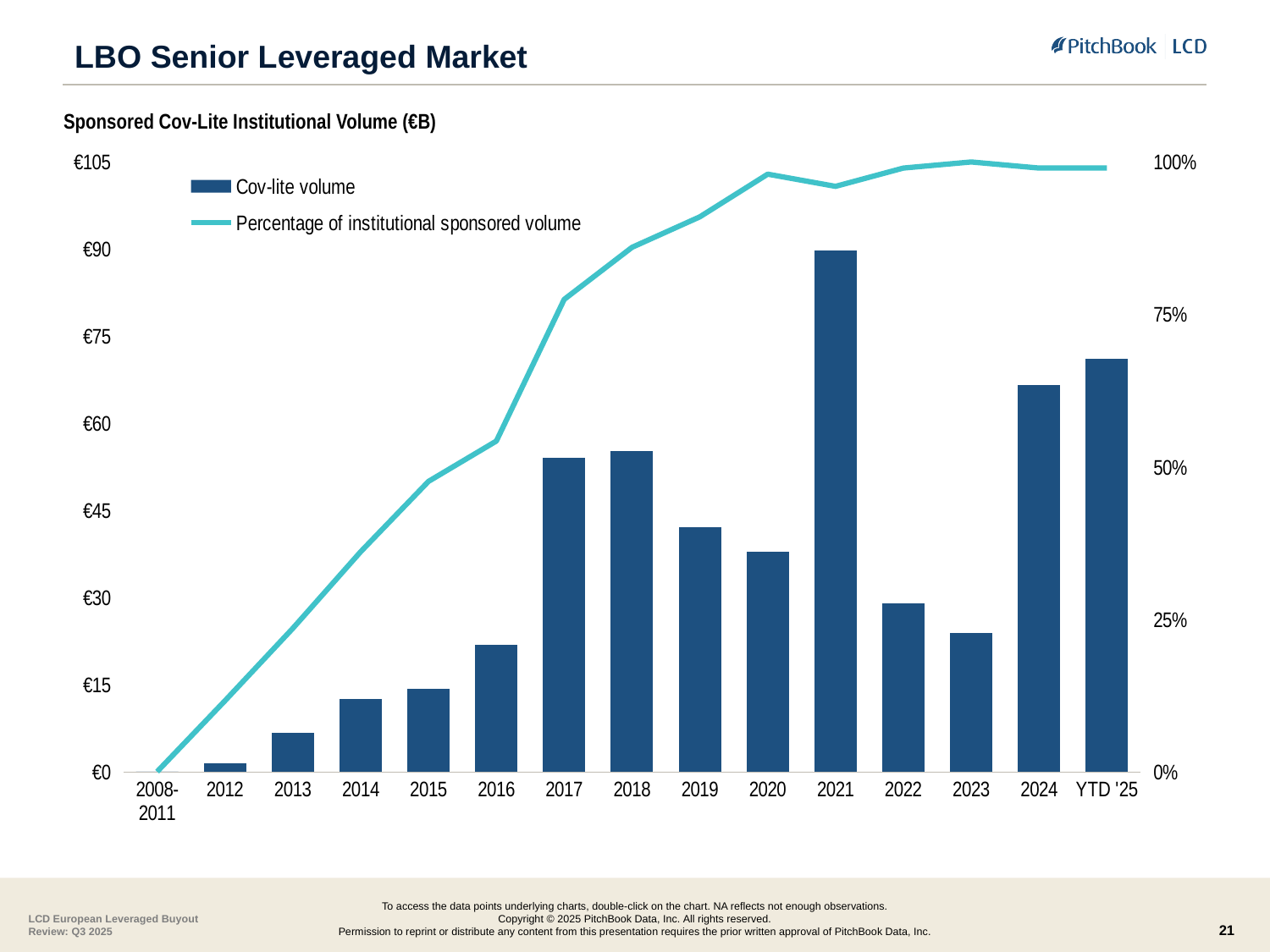
What is the title of the chart? Sponsored Cov-Lite Institutional Volume (€B) How many series does the legend list? 2 Which has the larger cov-lite volume, 2021 or 2024? 2021 Does the percentage of institutional sponsored volume rise or fall from 2008-2011 to 2020? rise Is the cov-lite volume for 2024 greater or less than €60B? greater How many categories are shown on the x axis? 15 Is the cov-lite volume for 2023 greater or less than €30B? less Is the percentage of institutional sponsored volume for 2018 greater or less than 75%? greater What kind of chart is shown on the slide? Combined bar and line chart Which year has the highest cov-lite volume? 2021